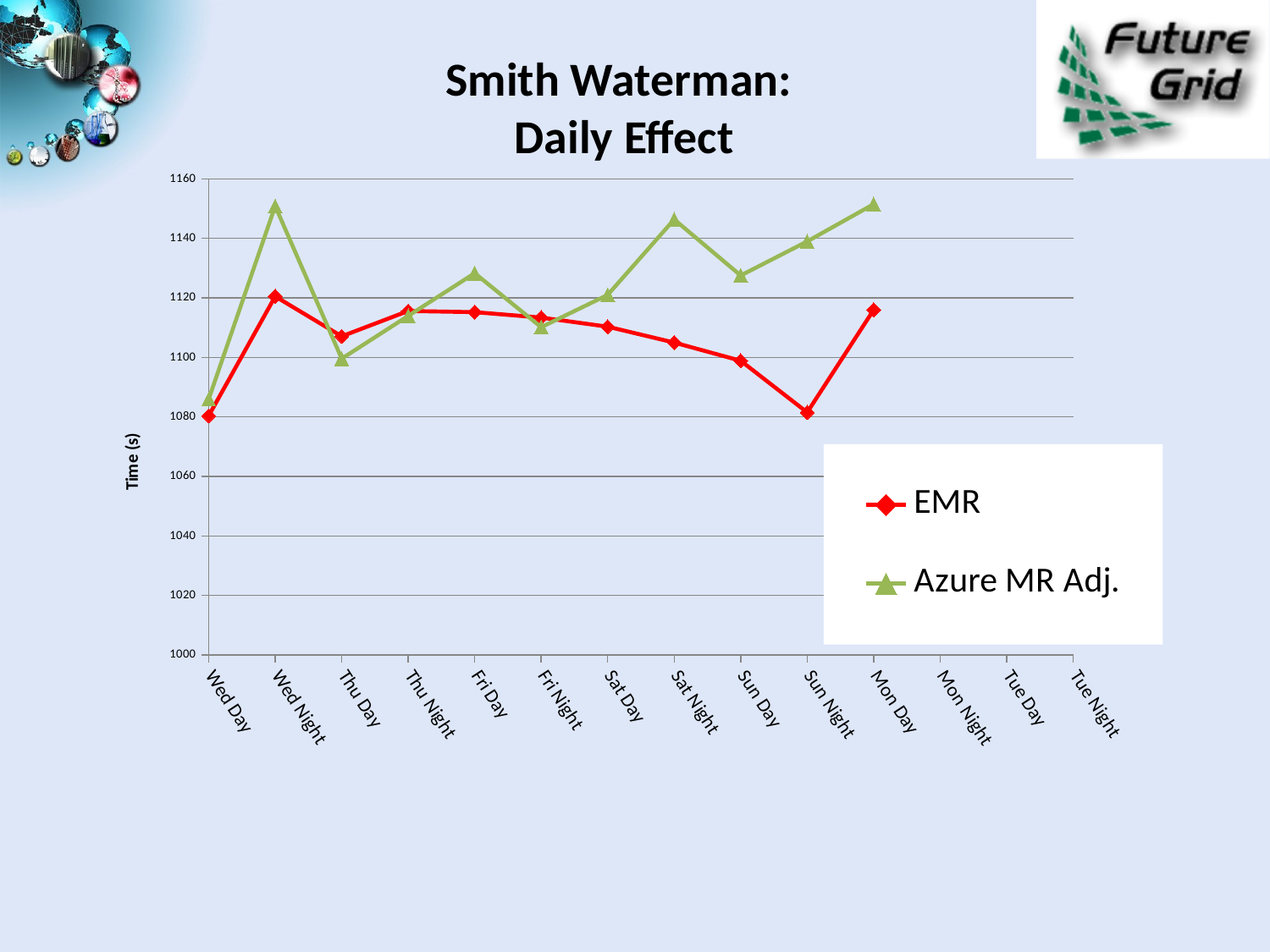
At Wed Night, which series has the higher value, EMR or Azure MR Adj.? Azure MR Adj. At Sun Night, which series has the higher value, EMR or Azure MR Adj.? Azure MR Adj. Is the EMR value for Sun Night greater or less than 1100? less Does the EMR series rise or fall from Thu Night to Sun Night? fall Is the Azure MR Adj. value for Wed Night greater or less than 1140? greater What are the two series named in the legend? EMR and Azure MR Adj. How many series does the legend list? 2 What kind of chart is shown on the slide? line chart Is the EMR value for Thu Day greater or less than 1100? greater What is the label of the vertical axis? Time (s) How many data points are plotted for the EMR series? 11